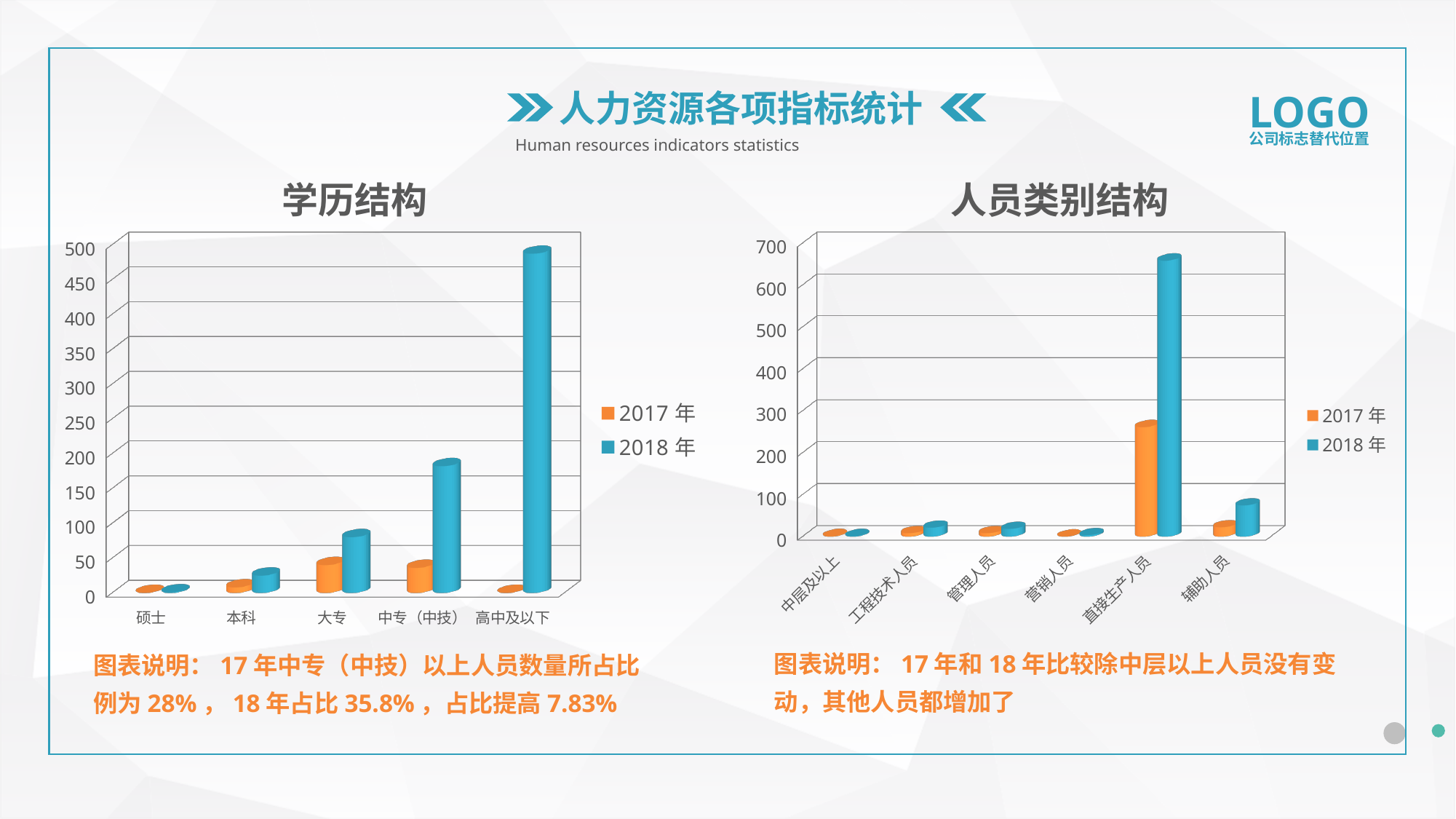
In the 学历结构 chart, is the 2018 年 value for 高中及以下 greater or less than 450? greater What kind of chart is the 学历结构 chart? bar chart How many series does the legend of the 学历结构 chart list? 2 In the 人员类别结构 chart, is the 2017 年 value for 直接生产人员 greater or less than 200? greater How many categories are shown on the x axis of the 学历结构 chart? 5 In the 人员类别结构 chart, which category has the highest 2018 年 value? 直接生产人员 How many categories are shown on the x axis of the 人员类别结构 chart? 6 In the 人员类别结构 chart, is the 2018 年 value for 直接生产人员 greater or less than 600? greater In the 人员类别结构 chart, which colour represents the 2017 年 series? orange In the 学历结构 chart, which is larger for 大专: the 2017 年 value or the 2018 年 value? 2018 年 In the 学历结构 chart, which category has the highest 2018 年 value? 高中及以下